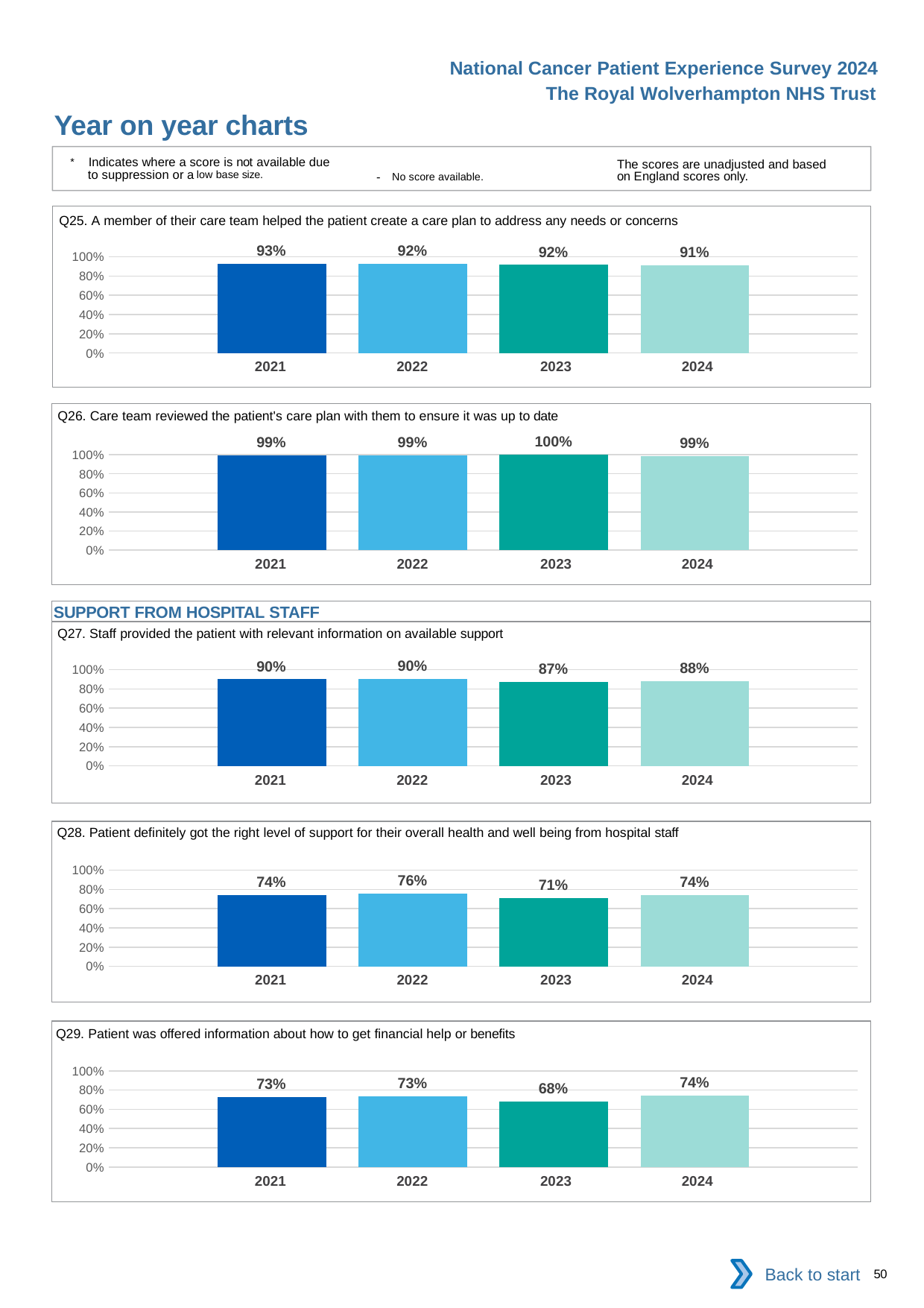
How many years are shown on the x axis of the Q28 chart? 4 In the Q29 chart, what is the difference between the 2024 value and the 2023 value? 6% In the Q25 chart, what is the value for 2021? 93% In the Q29 chart, which is larger, the value for 2023 or the value for 2024? 2024 In the Q25 chart, what is the value for 2024? 91% In the Q28 chart, what is the value for 2023? 71% In the Q26 chart, which year has the highest value? 2023 In the Q26 chart, what is the value for 2023? 100% In the Q27 chart, which year has the lowest value? 2023 In the Q28 chart, which year has the highest value? 2022 In the Q27 chart, what is the difference between the 2021 value and the 2023 value? 3% What kind of chart is the Q29 chart? Bar chart